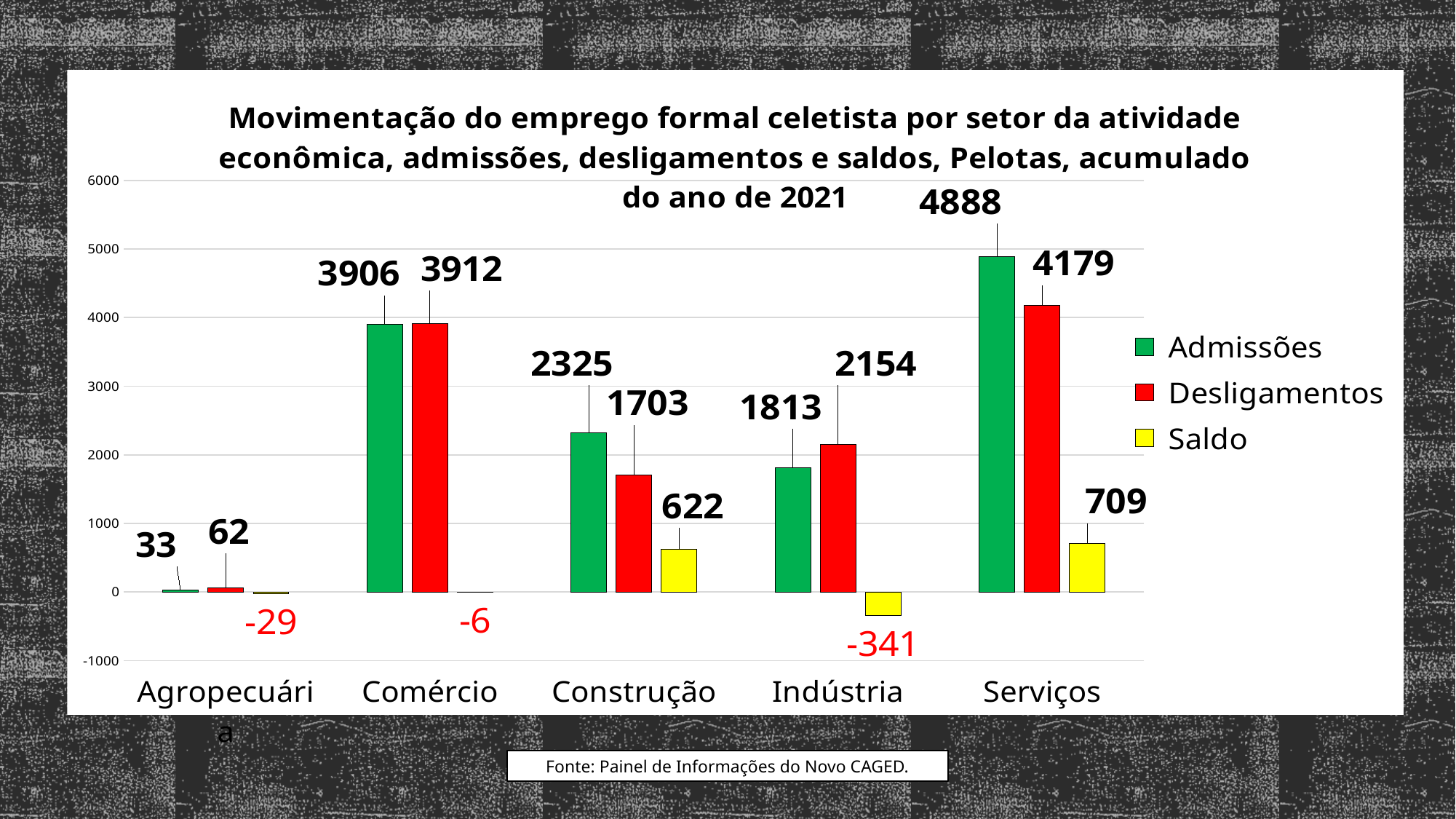
Is the Desligamentos value for Construção greater or less than 2000? less What is the Desligamentos value for Comércio? 3912 Which is larger for Indústria, Admissões or Desligamentos? Desligamentos What is the Saldo value for Construção? 622 What kind of chart is shown on the slide? bar chart Which sector has the highest Admissões value? Serviços What is the difference between Admissões and Desligamentos for Serviços? 709 Which sector has the lowest Saldo value? Indústria How many sectors are shown on the x axis? 5 What is the Saldo value for Indústria? -341 How many series does the legend list? 3 What is the Admissões value for Serviços? 4888